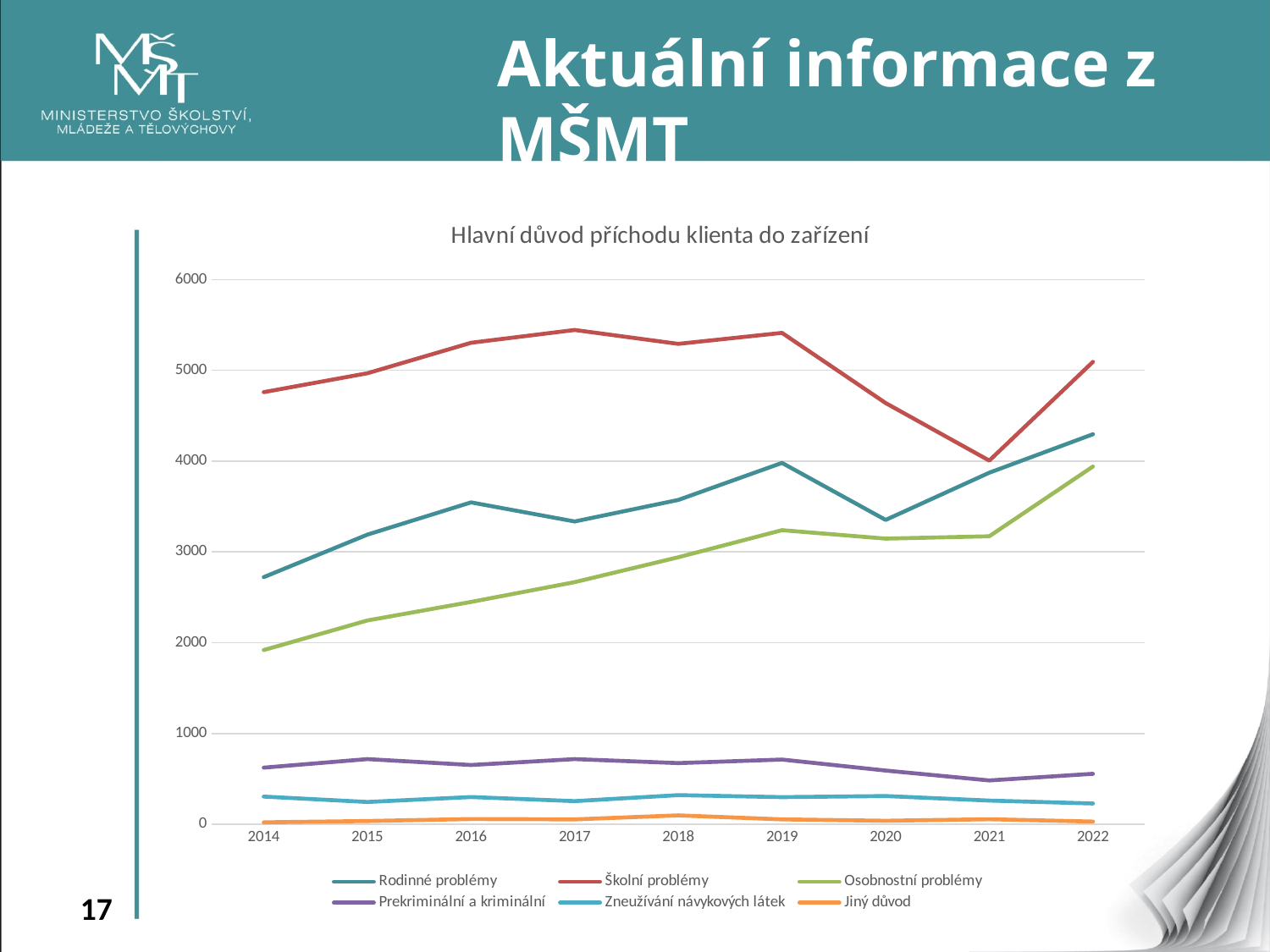
Does the Osobnostní problémy line generally rise or fall from 2014 to 2022? rise Is the value for Rodinné problémy in 2020 greater or less than 3000? greater In 2019, which is larger: Rodinné problémy or Osobnostní problémy? Rodinné problémy Is the value for Osobnostní problémy in 2014 greater or less than 2000? less What kind of chart is shown on the slide? line chart What is the title of the chart? Hlavní důvod příchodu klienta do zařízení Which series has the highest value in 2022? Školní problémy Is the value for Školní problémy in 2014 greater or less than 4000? greater How many series does the legend list? 6 How many years are shown on the x axis? 9 Which series has the lowest values across all years? Jiný důvod Does the Školní problémy line rise or fall from 2019 to 2021? fall